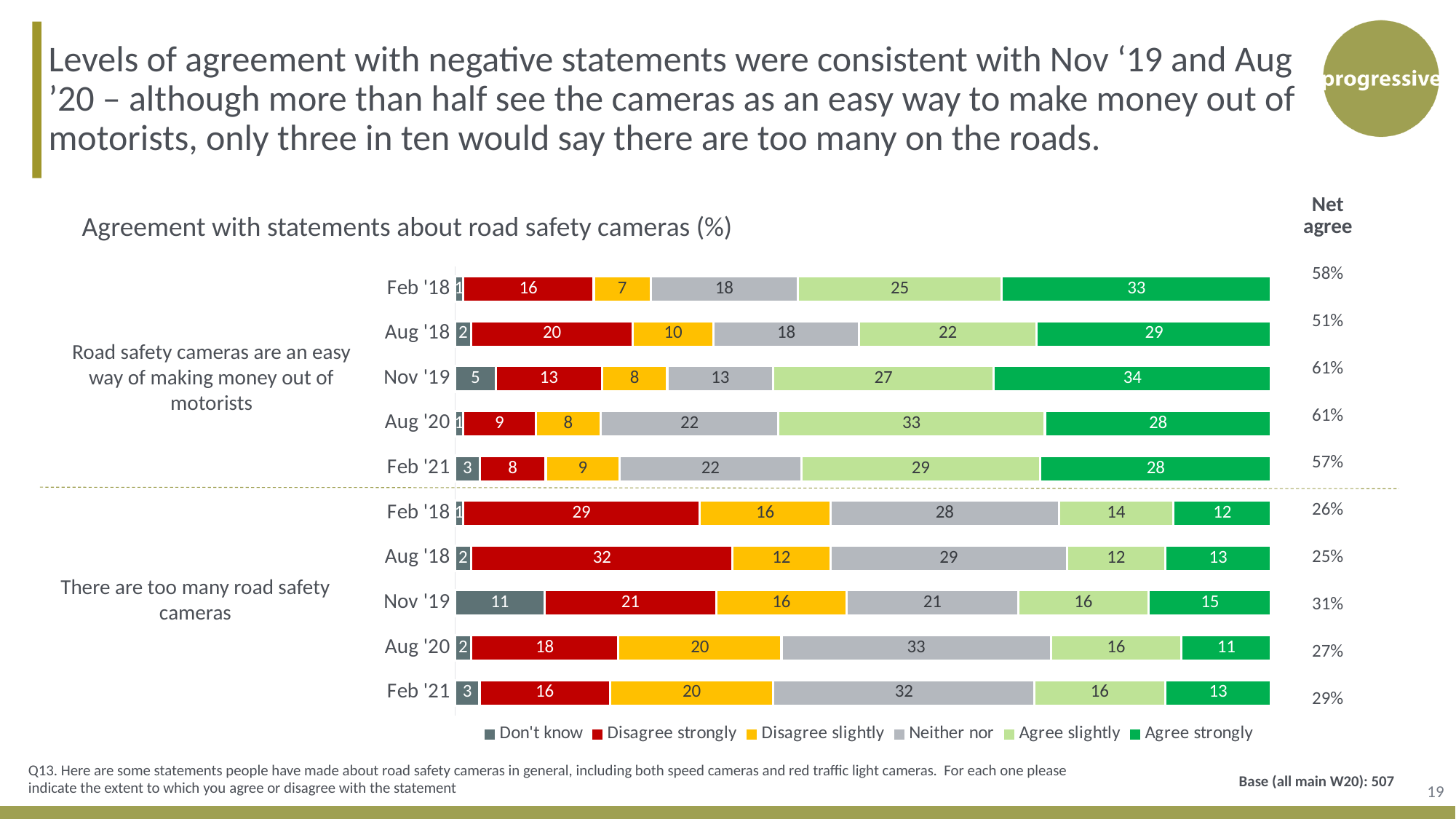
For 'There are too many road safety cameras', what is the difference between the 'Neither nor' values in Aug '20 and Nov '19? 12 For 'There are too many road safety cameras' in Nov '19, what is the total of the 'Agree slightly' and 'Agree strongly' segments? 31 What is the title of the chart? Agreement with statements about road safety cameras (%) How many series does the legend list? 6 Across the five waves for 'There are too many road safety cameras', which wave has the lowest net agree figure? Aug '18 Across the five waves for 'Road safety cameras are an easy way of making money out of motorists', which wave has the highest net agree figure? Nov '19 and Aug '20 (61%) What is the net agree figure for 'There are too many road safety cameras' in Feb '21? 29% For the statement 'There are too many road safety cameras', what percentage disagreed strongly in Aug '18? 32 How many survey waves are shown for each statement? 5 For the statement 'Road safety cameras are an easy way of making money out of motorists', what percentage agreed strongly in Nov '19? 34 For 'Road safety cameras are an easy way of making money out of motorists', which is larger: 'Agree slightly' in Aug '20 or 'Agree slightly' in Feb '18? Aug '20 What kind of chart is shown on the slide? Stacked bar chart